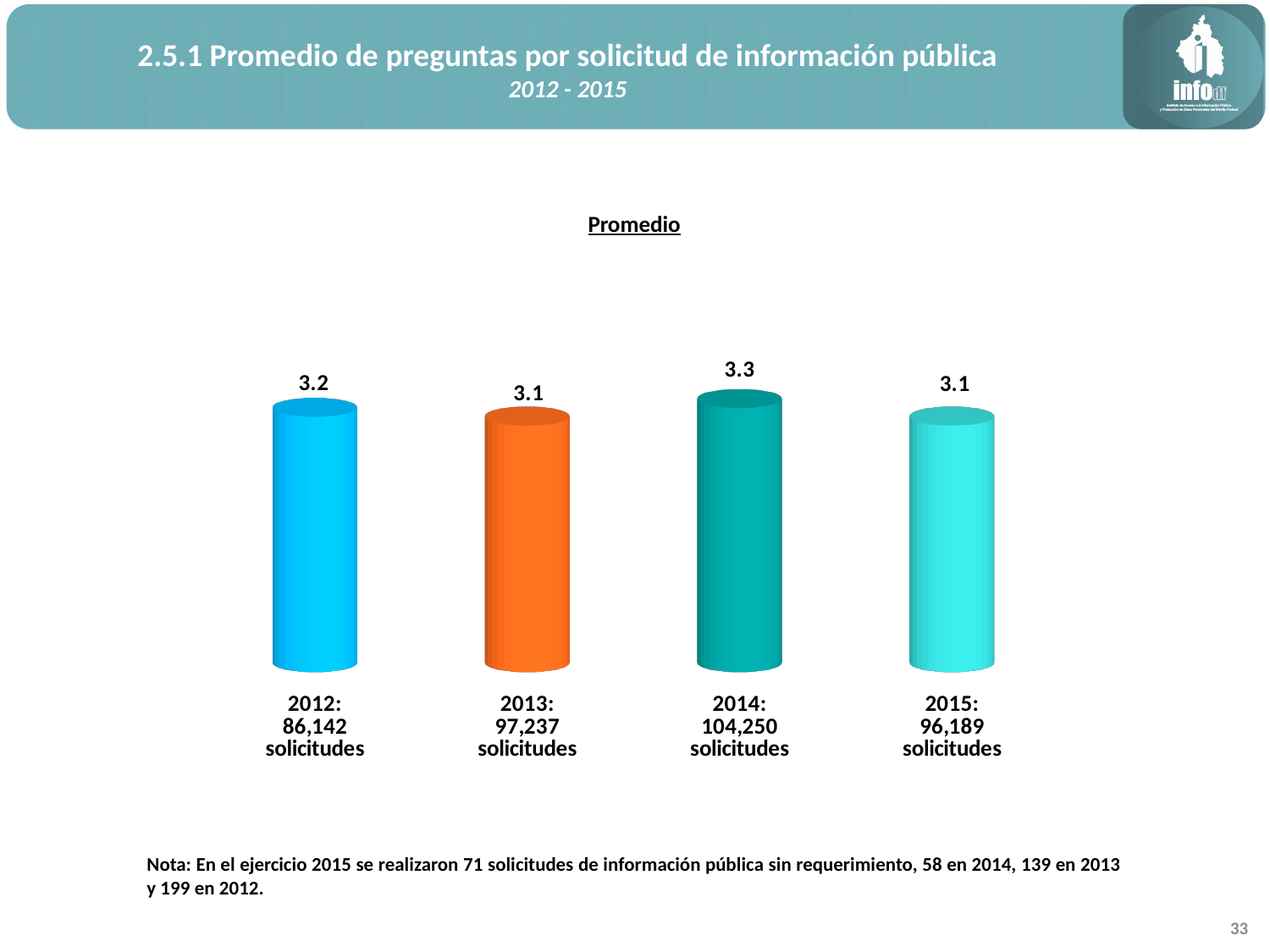
What is the average value shown for 2015? 3.1 What is the label shown above the chart? Promedio What is the difference between the average for 2014 and the average for 2013? 0.2 How many years (bars) are shown in the chart? 4 How many solicitudes are listed in the category label for 2014? 104,250 How many solicitudes are listed in the category label for 2012? 86,142 What is the average value shown for 2014? 3.3 What is the average number of questions per request shown for 2012? 3.2 Which year has the highest average number of questions per request? 2014 What kind of chart is shown on the slide? Bar chart What is the difference between the average for 2012 and the average for 2013? 0.1 Which is larger, the average for 2012 or the average for 2014? 2014